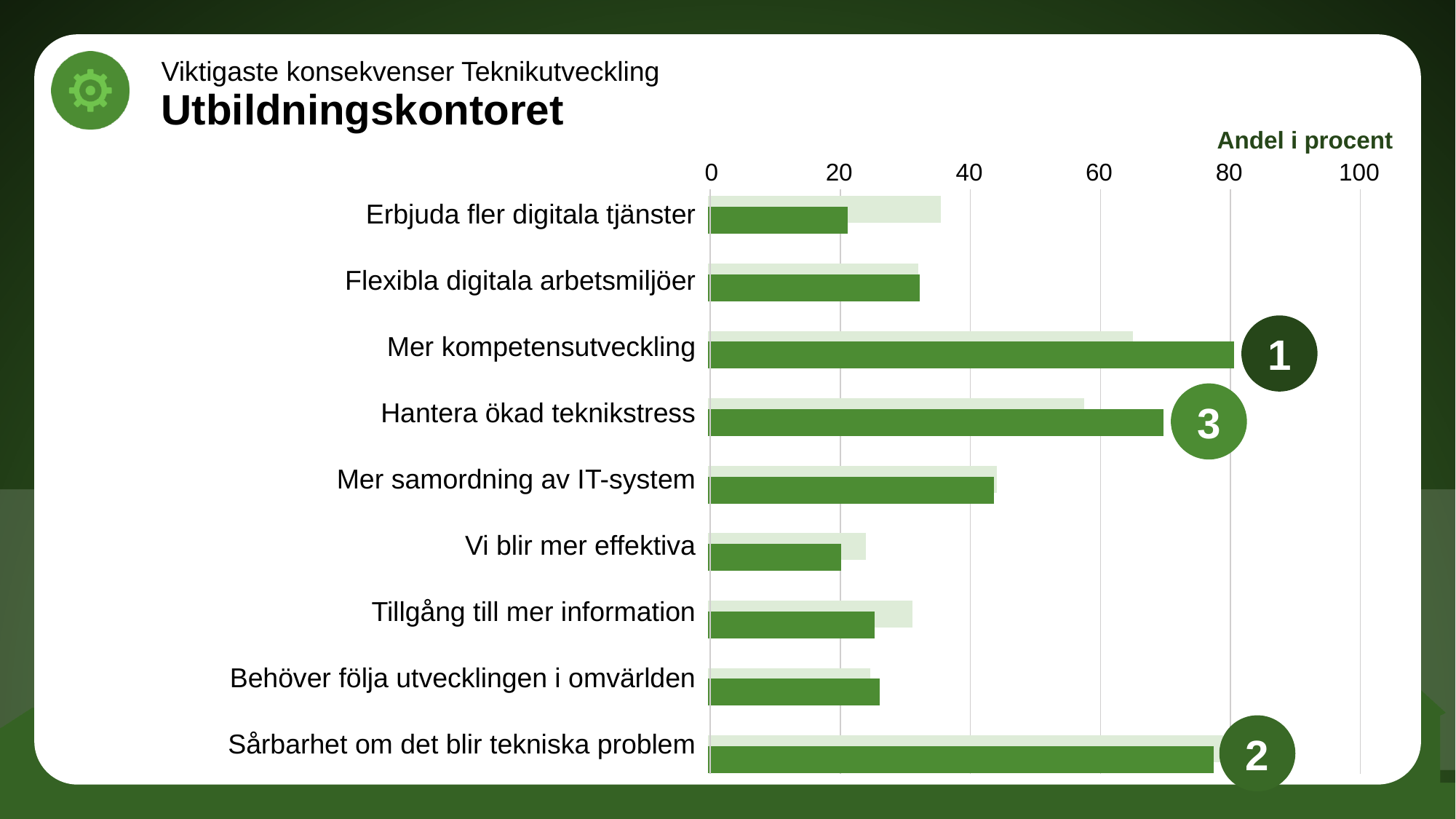
Is the dark green bar for Sårbarhet om det blir tekniska problem greater or less than 60? greater Is the dark green bar for Mer samordning av IT-system greater or less than 40? greater Is the dark green bar for Erbjuda fler digitala tjänster greater or less than 40? less What label is shown above the horizontal axis of the chart? Andel i procent Which has the longer dark green bar, Sårbarhet om det blir tekniska problem or Tillgång till mer information? Sårbarhet om det blir tekniska problem What kind of chart is shown on the slide? bar chart Which has the longer dark green bar, Mer kompetensutveckling or Hantera ökad teknikstress? Mer kompetensutveckling How many categories are shown on the chart? 9 Which category has the longest dark green bar? Mer kompetensutveckling